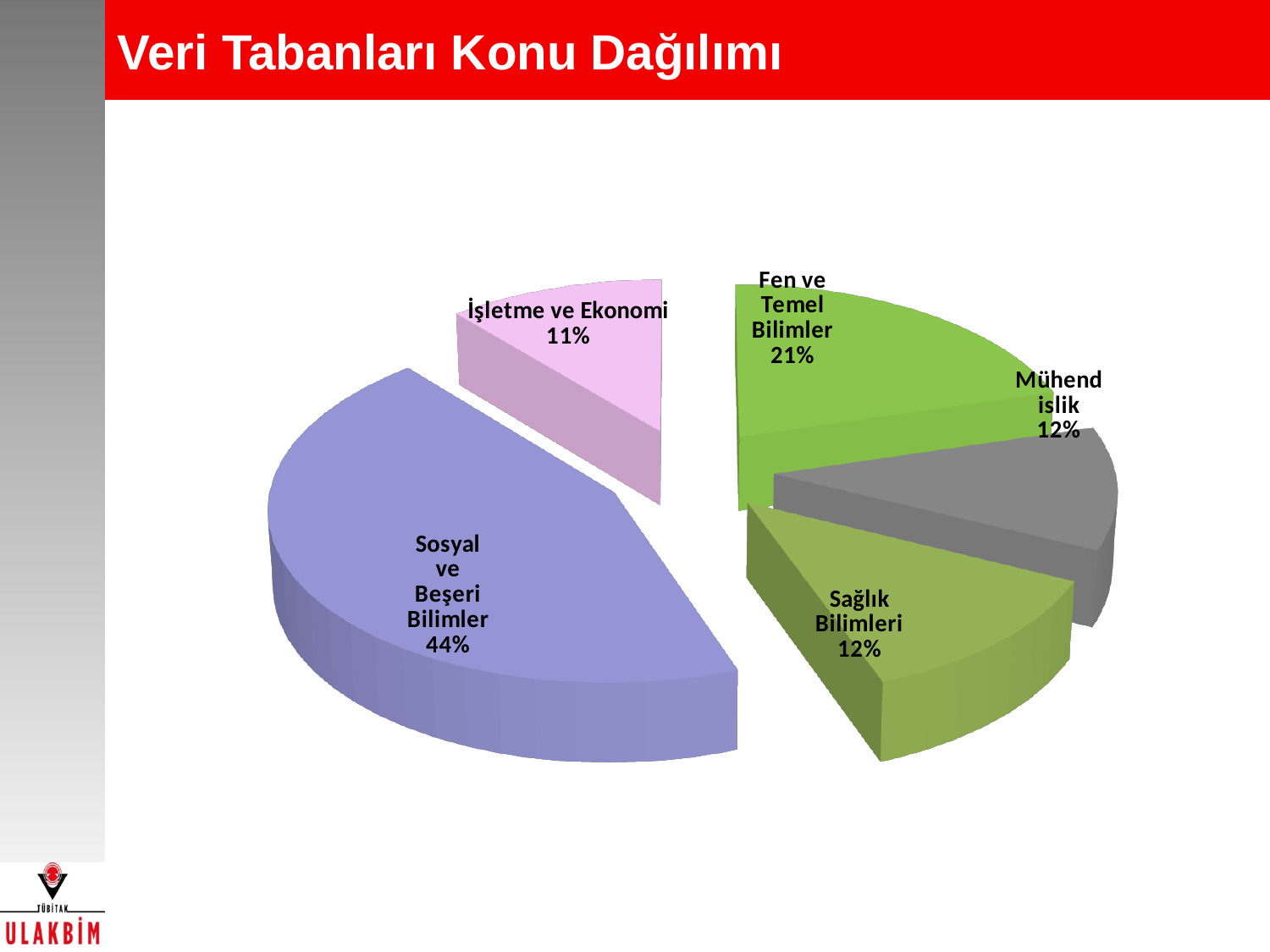
What is the value shown for Sağlık Bilimleri? 12% What is the value shown for İşletme ve Ekonomi? 11% Which category has the smallest share of the pie? İşletme ve Ekonomi What is the value shown for Fen ve Temel Bilimler? 21% What is the title of the slide containing the chart? Veri Tabanları Konu Dağılımı What is the difference in percentage points between Sosyal ve Beşeri Bilimler and Fen ve Temel Bilimler? 23 percentage points Which category has the largest share of the pie? Sosyal ve Beşeri Bilimler What is the value shown for Mühendislik? 12% How many slices does the pie chart have? 5 What type of chart is shown on the slide? Pie chart What share of the pie does Sosyal ve Beşeri Bilimler have? 44% Which is larger, the share for Fen ve Temel Bilimler or the share for Mühendislik? Fen ve Temel Bilimler